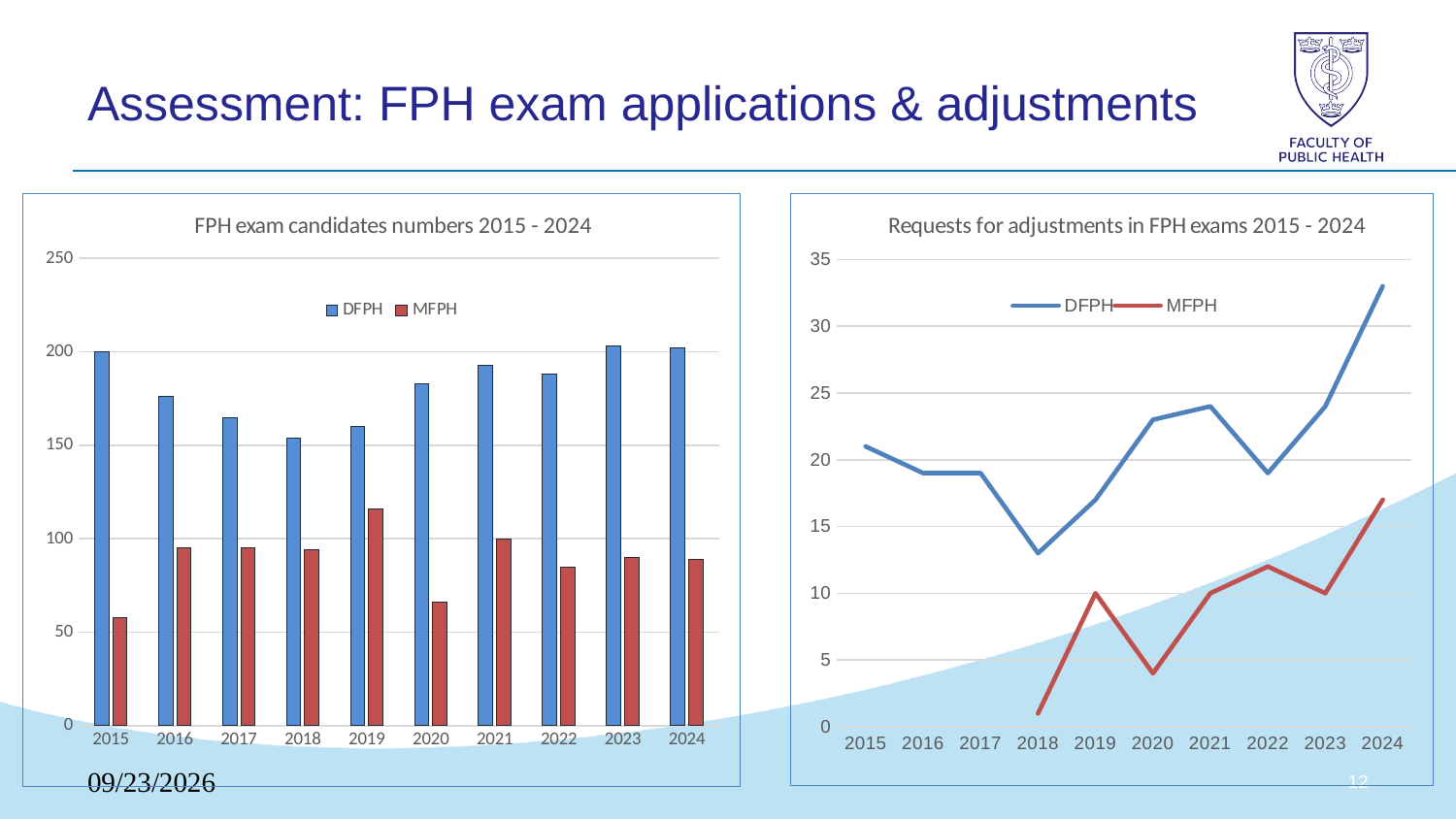
In the 'Requests for adjustments in FPH exams 2015 - 2024' chart, is the DFPH value for 2024 greater or less than 30? greater What kind of chart is the 'Requests for adjustments in FPH exams 2015 - 2024' chart? line chart In the 'Requests for adjustments in FPH exams 2015 - 2024' chart, which year has the lowest DFPH value? 2018 What kind of chart is the 'FPH exam candidates numbers 2015 - 2024' chart? bar chart In the 'FPH exam candidates numbers 2015 - 2024' chart, which is larger in 2021, DFPH or MFPH? DFPH In the 'FPH exam candidates numbers 2015 - 2024' chart, is the DFPH value for 2018 greater or less than 150? greater In the 'Requests for adjustments in FPH exams 2015 - 2024' chart, which year has the highest DFPH value? 2024 In the 'FPH exam candidates numbers 2015 - 2024' chart, which year has the highest MFPH value? 2019 In the 'FPH exam candidates numbers 2015 - 2024' chart, which year has the lowest MFPH value? 2015 In the 'FPH exam candidates numbers 2015 - 2024' chart, how many series does the legend list? 2 In the 'FPH exam candidates numbers 2015 - 2024' chart, is the MFPH value for 2020 greater or less than 100? less In the 'FPH exam candidates numbers 2015 - 2024' chart, how many years are shown on the x axis? 10